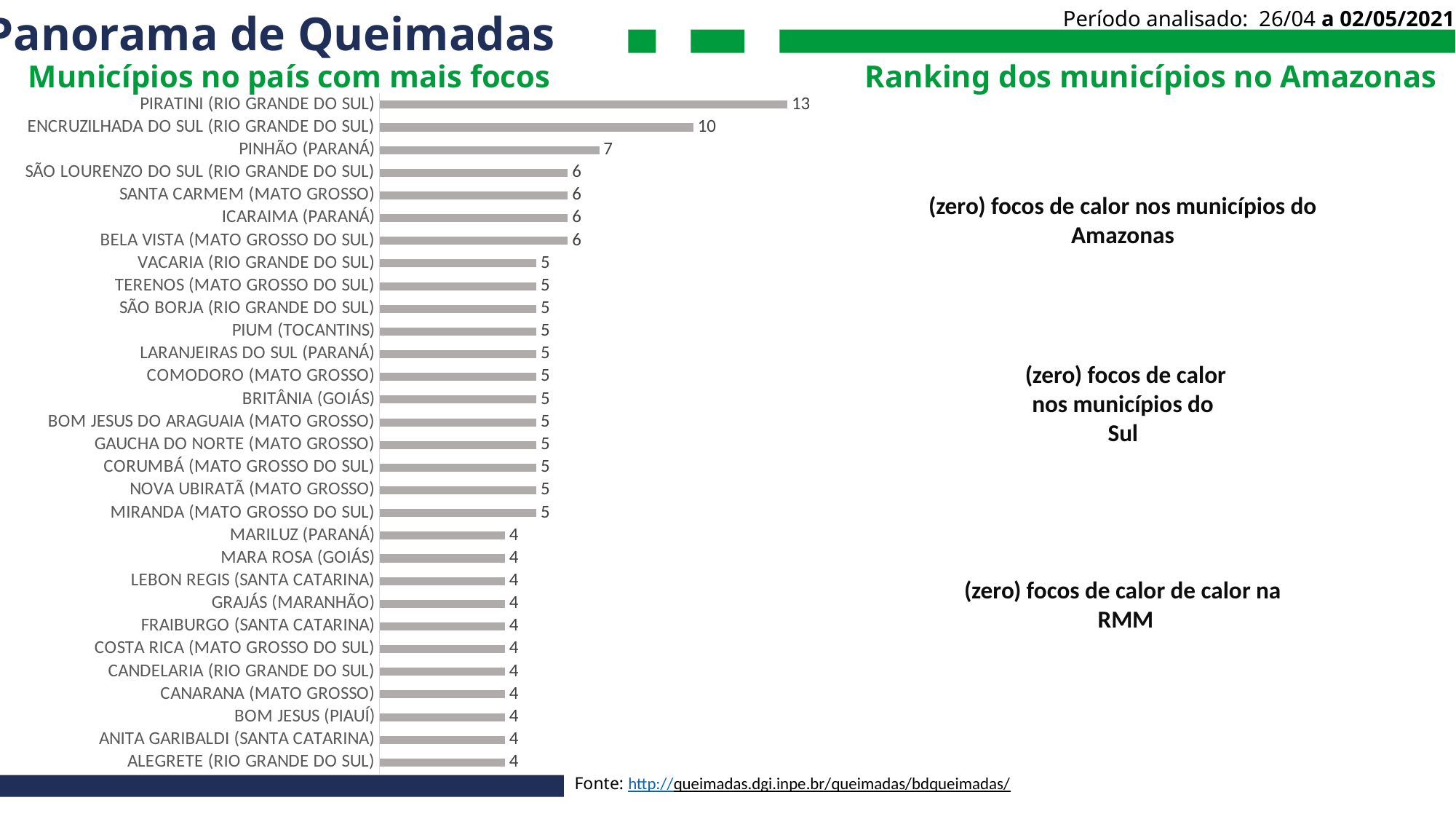
What is the value for PINHÃO (PARANÁ)? 7 How many municipalities are listed in the bar chart? 30 What is the value for PIUM (TOCANTINS)? 5 What is the value for ENCRUZILHADA DO SUL (RIO GRANDE DO SUL)? 10 What is the title of the bar chart on the left of the slide? Municípios no país com mais focos What is the value for BELA VISTA (MATO GROSSO DO SUL)? 6 What is the value for PIRATINI (RIO GRANDE DO SUL)? 13 What is the difference between the values for PIRATINI (RIO GRANDE DO SUL) and ENCRUZILHADA DO SUL (RIO GRANDE DO SUL)? 3 Which municipality has the highest number of focos in the chart? PIRATINI (RIO GRANDE DO SUL) What is the value for ALEGRETE (RIO GRANDE DO SUL)? 4 What kind of chart is shown under "Municípios no país com mais focos"? bar chart Which has a larger value, PINHÃO (PARANÁ) or VACARIA (RIO GRANDE DO SUL)? PINHÃO (PARANÁ)